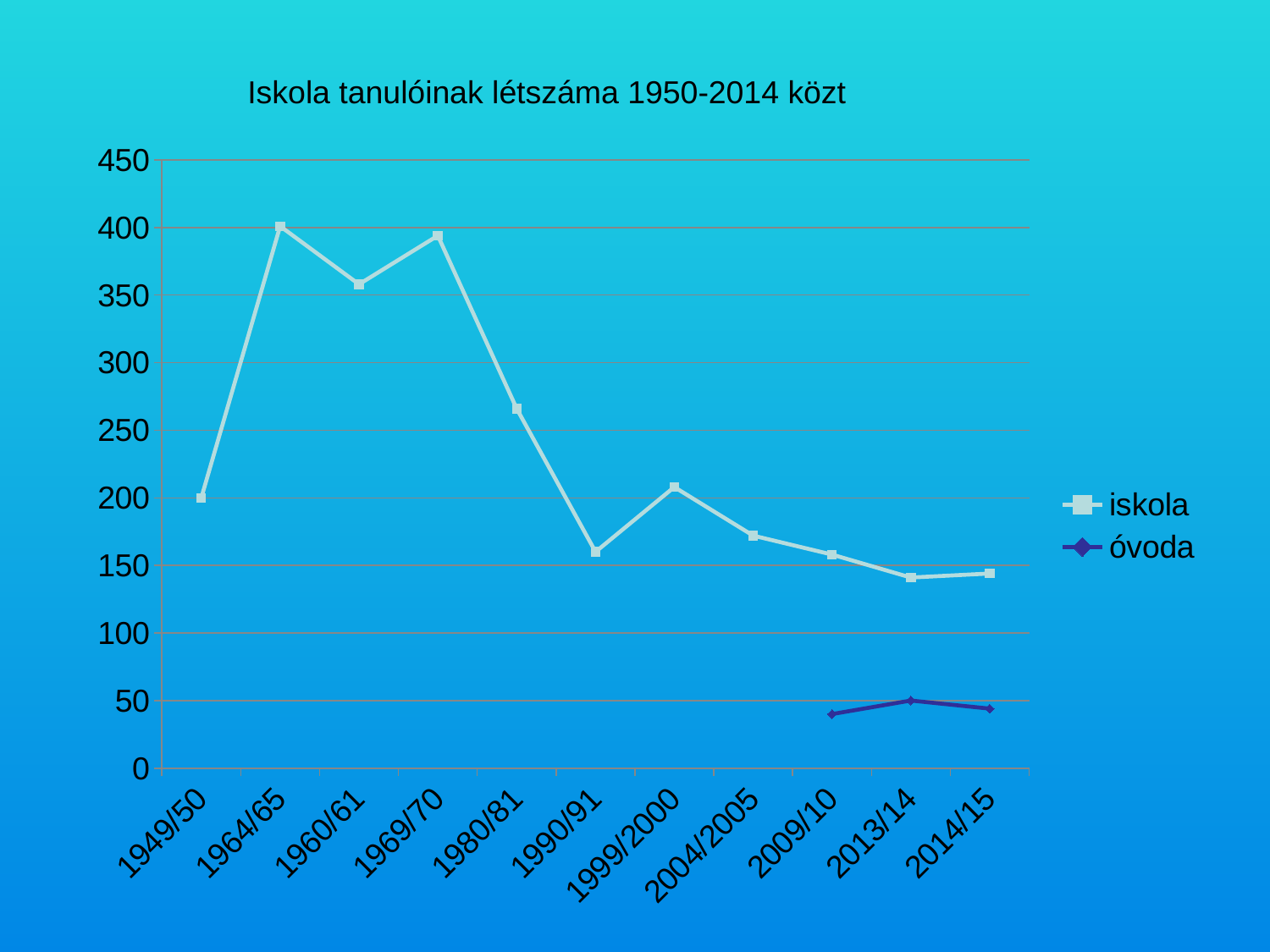
What is the title of the chart? Iskola tanulóinak létszáma 1950-2014 közt What kind of chart is shown on the slide? line chart Is the iskola value for 1990/91 greater or less than 200? less Is the óvoda value for 2009/10 greater or less than 50? less Does the iskola series rise or fall from 1969/70 to 1990/91? fall Is the iskola value for 1960/61 greater or less than 350? greater In which school year does the iskola series reach its highest value? 1964/65 How many series does the legend list? 2 How many school-year categories are shown on the x axis? 11 Which has the larger iskola value, 1960/61 or 1969/70? 1969/70